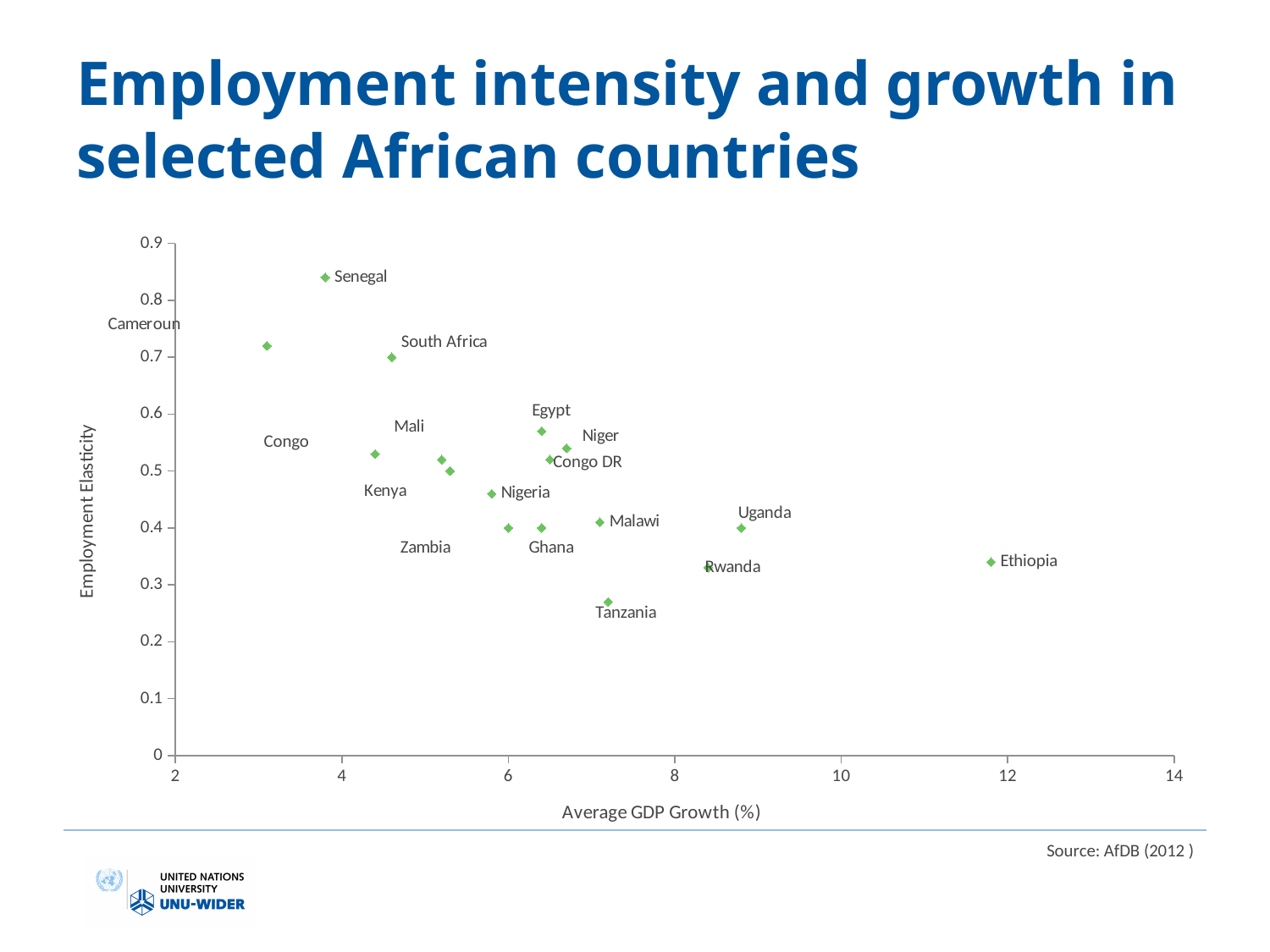
How many countries are plotted on the chart? 17 Is the employment elasticity for Tanzania greater or less than 0.3? less What kind of chart is shown on the slide? Scatter chart Which country has the lowest average GDP growth? Cameroun Is the employment elasticity for Senegal greater or less than 0.8? greater Which country has a higher average GDP growth, Uganda or Kenya? Uganda Which country has a higher employment elasticity, South Africa or Malawi? South Africa Which country has the highest employment elasticity? Senegal Is the average GDP growth for Ethiopia greater or less than 10? greater Which country has the lowest employment elasticity? Tanzania Which country has the highest average GDP growth? Ethiopia What is the label of the x axis? Average GDP Growth (%)